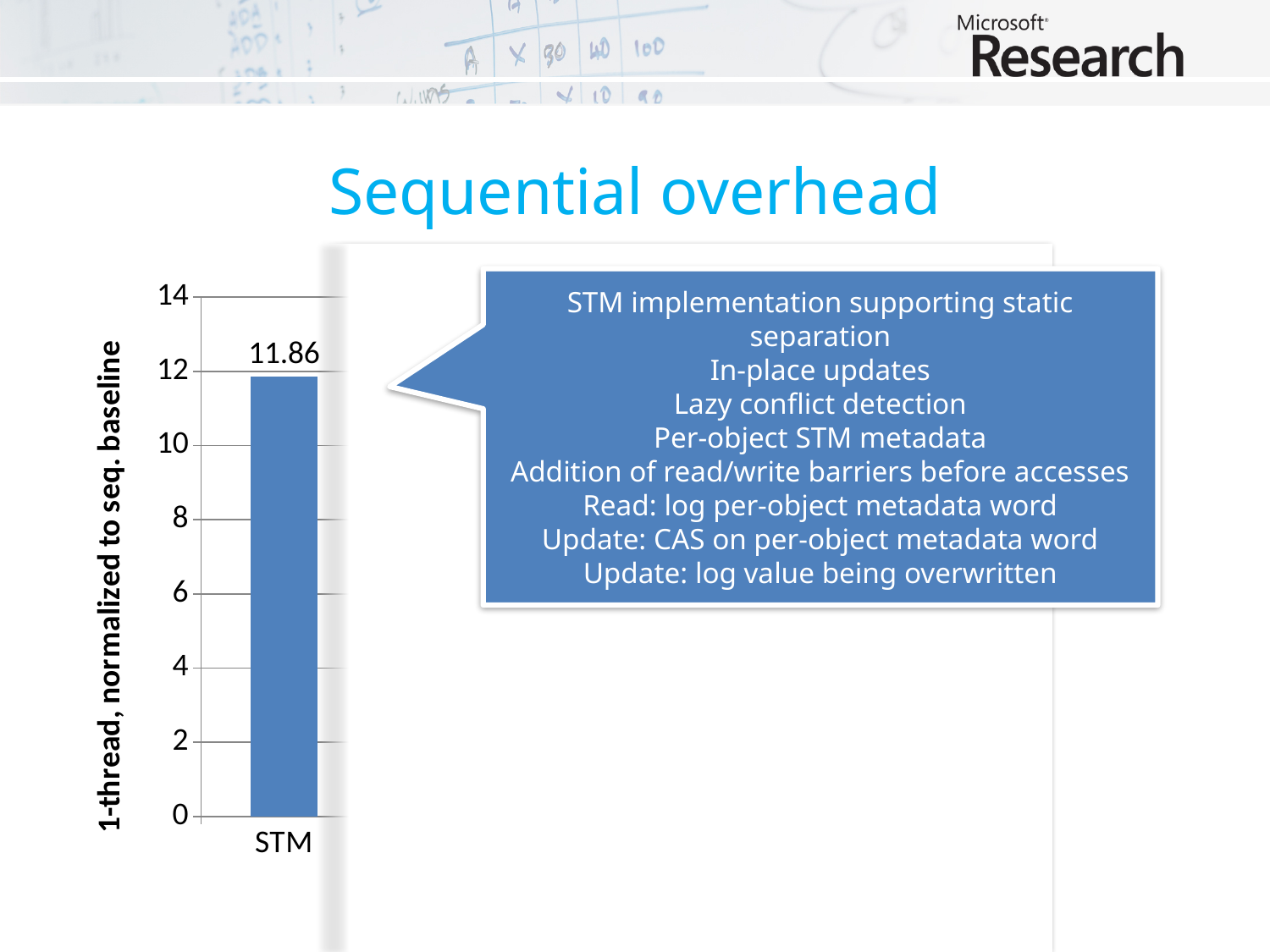
Is the value for STM greater or less than 10? greater What kind of chart is shown on the slide? bar chart What is the highest tick value shown on the y axis? 14 How many bars are visible in the chart? 1 Is the value for STM greater or less than 12? less What is the y-axis label of the chart? 1-thread, normalized to seq. baseline What is the value of the STM bar? 11.86 What is the label of the category shown on the x axis? STM